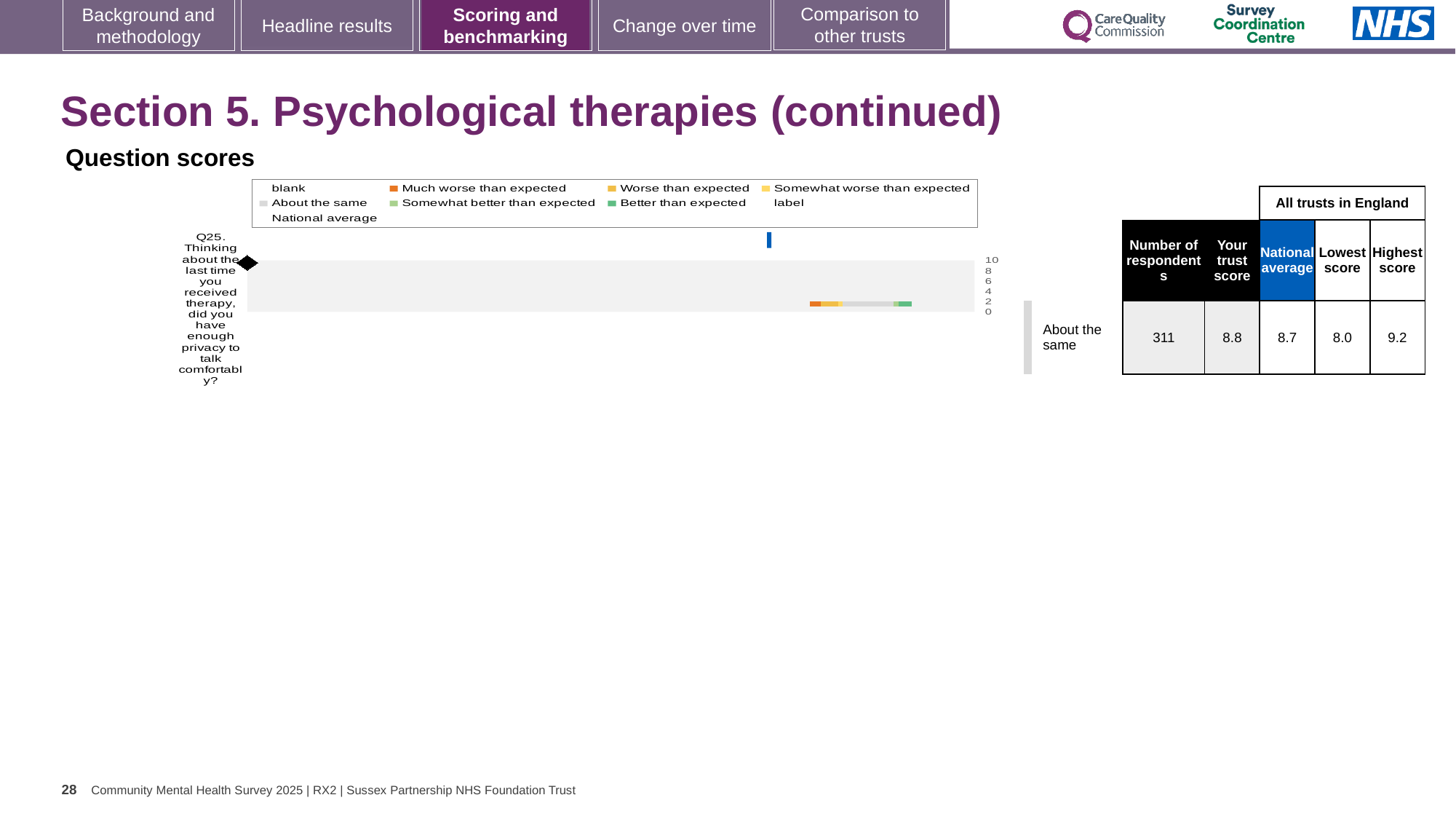
How is the trust's Q25 score categorised relative to what is expected? About the same What is the difference between the highest score and the lowest score for Q25? 1.2 What is the lowest score among all trusts in England for Q25? 8.0 Which is larger for Q25, the trust score or the national average? Trust score What is the trust's score for Q25 according to the table? 8.8 What is the highest score among all trusts in England for Q25? 9.2 How many respondents answered Q25? 311 How many questions are plotted on the chart? 1 Which question is shown on the chart? Q25. Thinking about the last time you received therapy, did you have enough privacy to talk comfortably? What is the maximum value shown on the chart's score axis? 10 What kind of chart is shown on the slide? Bar chart What is the national average score for Q25? 8.7